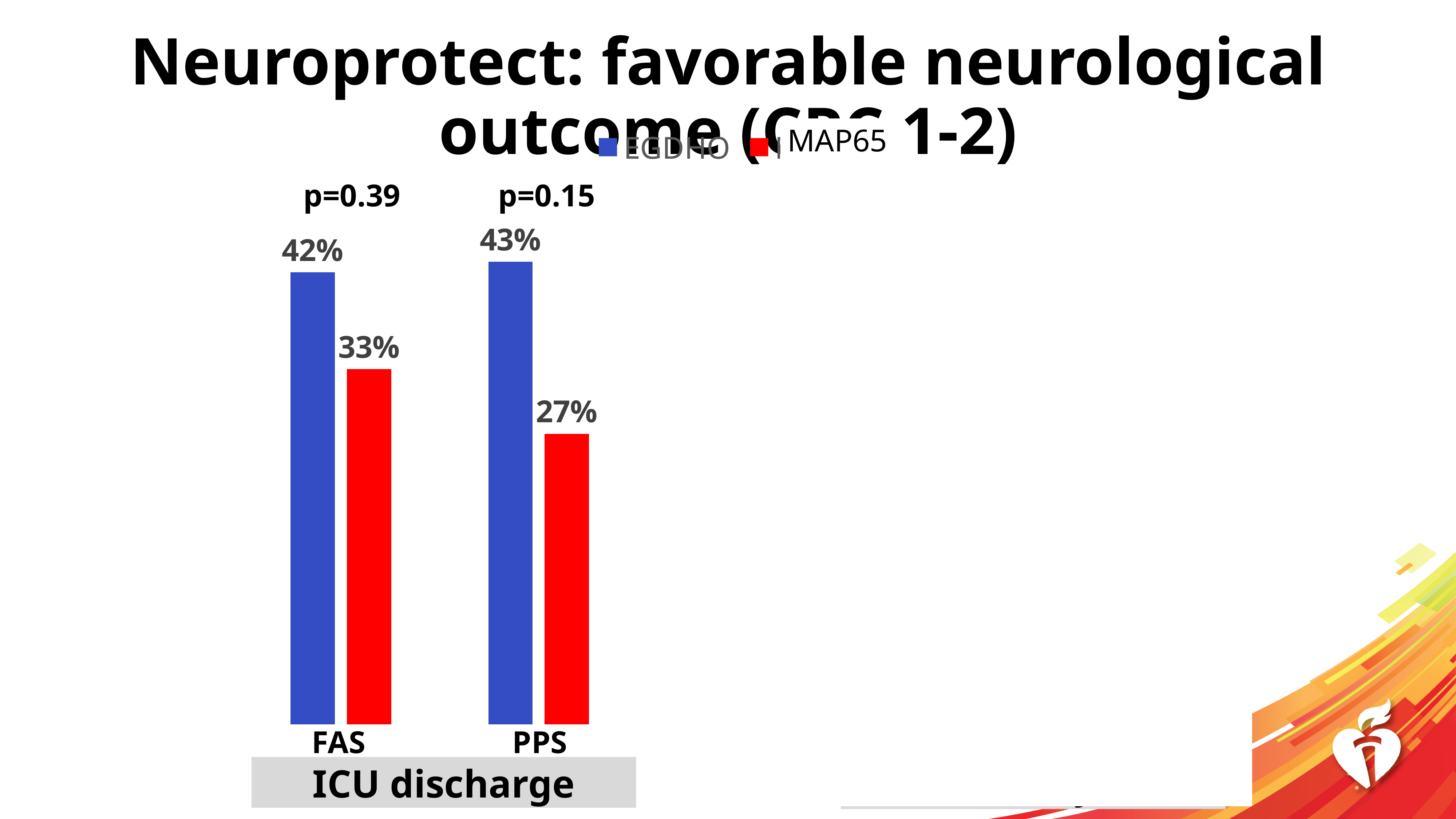
How many categories are shown on the x axis of the chart? 2 Which is larger, the MAP65 value for FAS or the MAP65 value for PPS? MAP65 for FAS What kind of chart is shown on the slide? Bar chart Which is larger for FAS, the EGDHO value or the MAP65 value? EGDHO What is the EGDHO value for PPS at ICU discharge? 43% How many series does the legend list? 2 What is the difference between the EGDHO and MAP65 values for PPS? 16% Which bar has the lowest value on the chart? MAP65 for PPS What is the MAP65 value for FAS at ICU discharge? 33% What is the EGDHO value for FAS at ICU discharge? 42% What is the difference between the EGDHO and MAP65 values for FAS? 9% What is the MAP65 value for PPS at ICU discharge? 27%